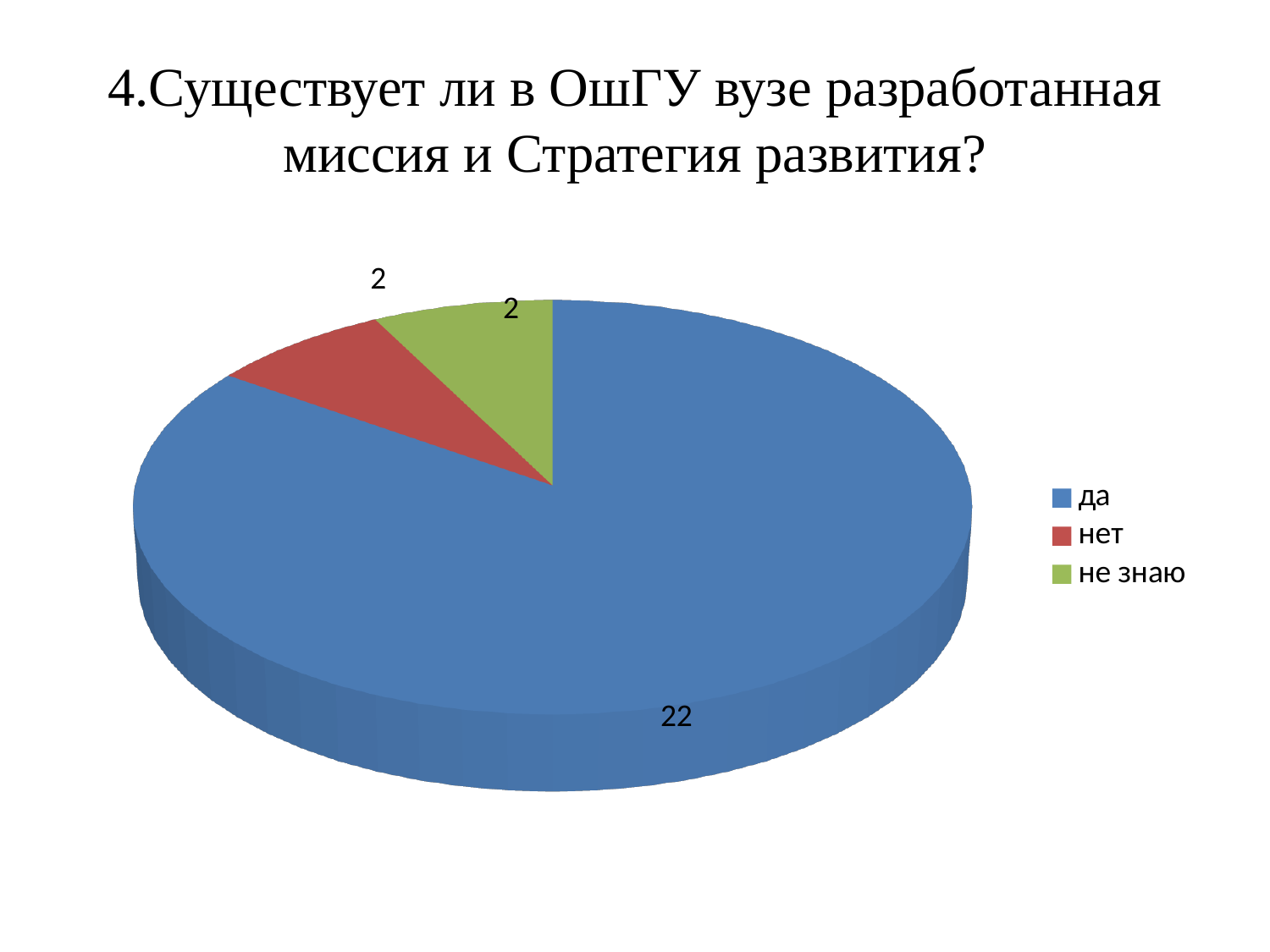
What colour is the "да" slice? blue What is the total of all slices in the pie chart? 26 What is the difference between the values for "да" and "нет"? 20 What is the value for the "нет" slice? 2 What colour is the "не знаю" slice? green What type of chart is shown on the slide? pie chart Which category has the largest slice of the pie? да Which is larger, the value for "да" or the value for "не знаю"? да What is the value for the "не знаю" slice? 2 How many entries does the legend list? 3 How many categories does the pie chart have? 3 What is the value for the "да" slice? 22